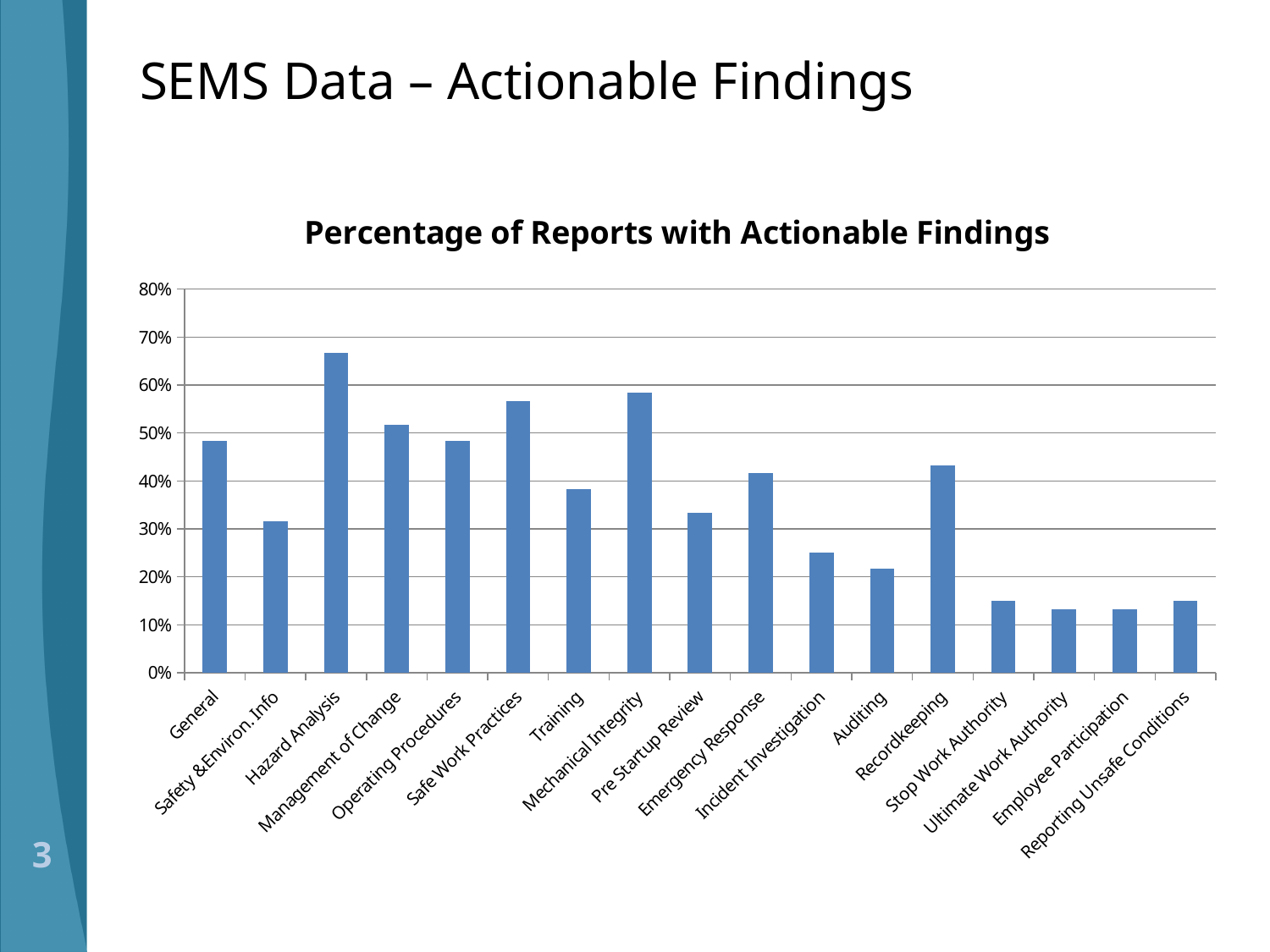
What is the highest value shown on the vertical axis of the chart? 80% Is the value for Stop Work Authority greater or less than 20%? less Which is larger, the value for Hazard Analysis or the value for Mechanical Integrity? Hazard Analysis What kind of chart is shown on the slide? bar chart Is the value for Incident Investigation greater or less than 20%? greater Is the value for Hazard Analysis greater or less than 60%? greater Which is larger, the value for Emergency Response or the value for Pre Startup Review? Emergency Response What is the title of the chart? Percentage of Reports with Actionable Findings Which category has the highest percentage of reports with actionable findings? Hazard Analysis How many categories are shown on the x axis of the chart? 17